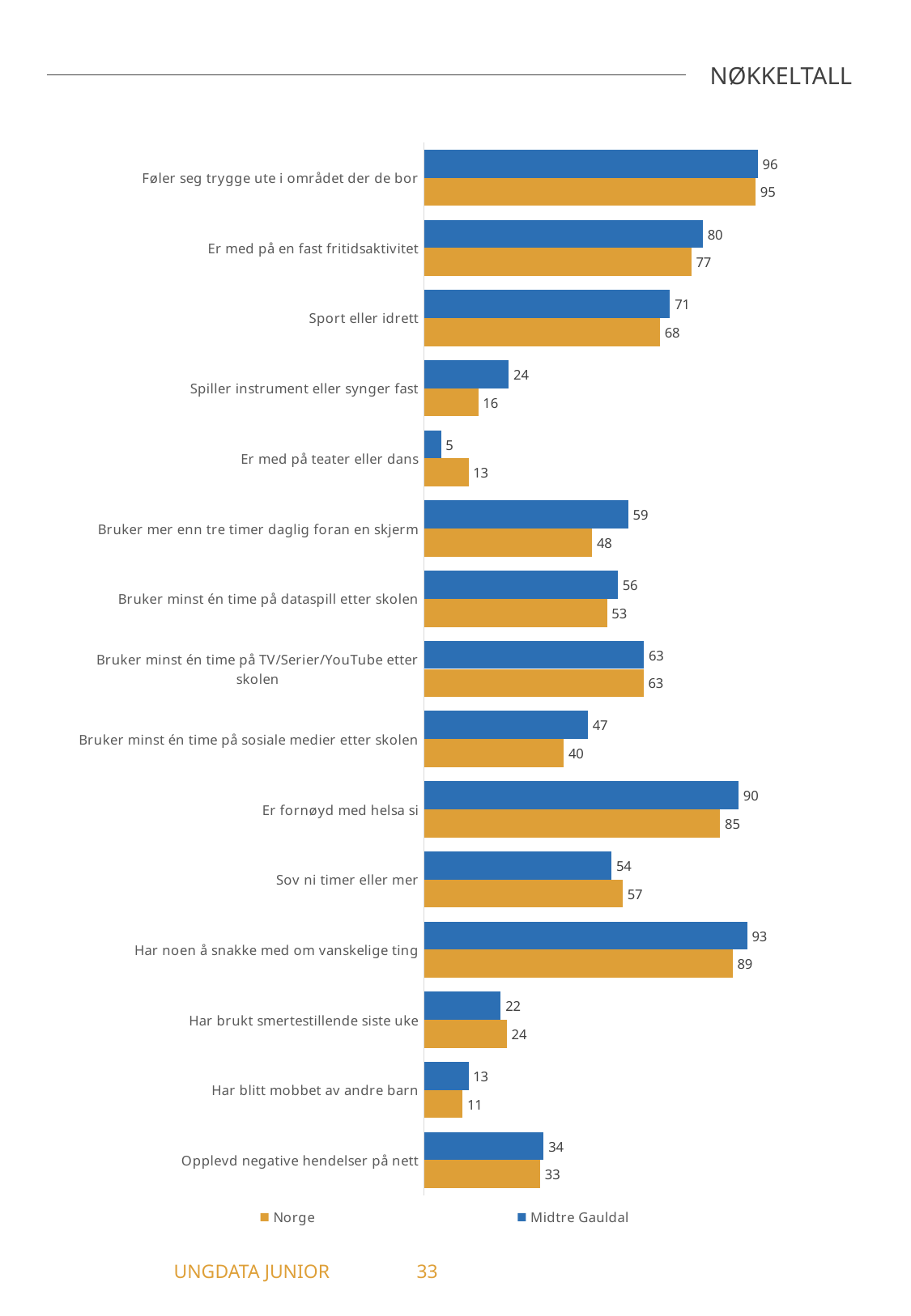
How many categories are shown in the chart? 15 Which category has the lowest value for Midtre Gauldal? Er med på teater eller dans What kind of chart is shown on the slide? Bar chart What is the value for Norge for "Sov ni timer eller mer"? 57 What is the value for Midtre Gauldal for "Føler seg trygge ute i området der de bor"? 96 What is the difference between Midtre Gauldal and Norge for "Bruker mer enn tre timer daglig foran en skjerm"? 11 What is the value for Norge for "Spiller instrument eller synger fast"? 16 Which is larger for "Er med på teater eller dans": Norge or Midtre Gauldal? Norge Which category has the highest value for Midtre Gauldal? Føler seg trygge ute i området der de bor How many series does the legend list? 2 Which is larger for "Er fornøyd med helsa si": Norge or Midtre Gauldal? Midtre Gauldal Which colour represents Norge in the chart? Orange